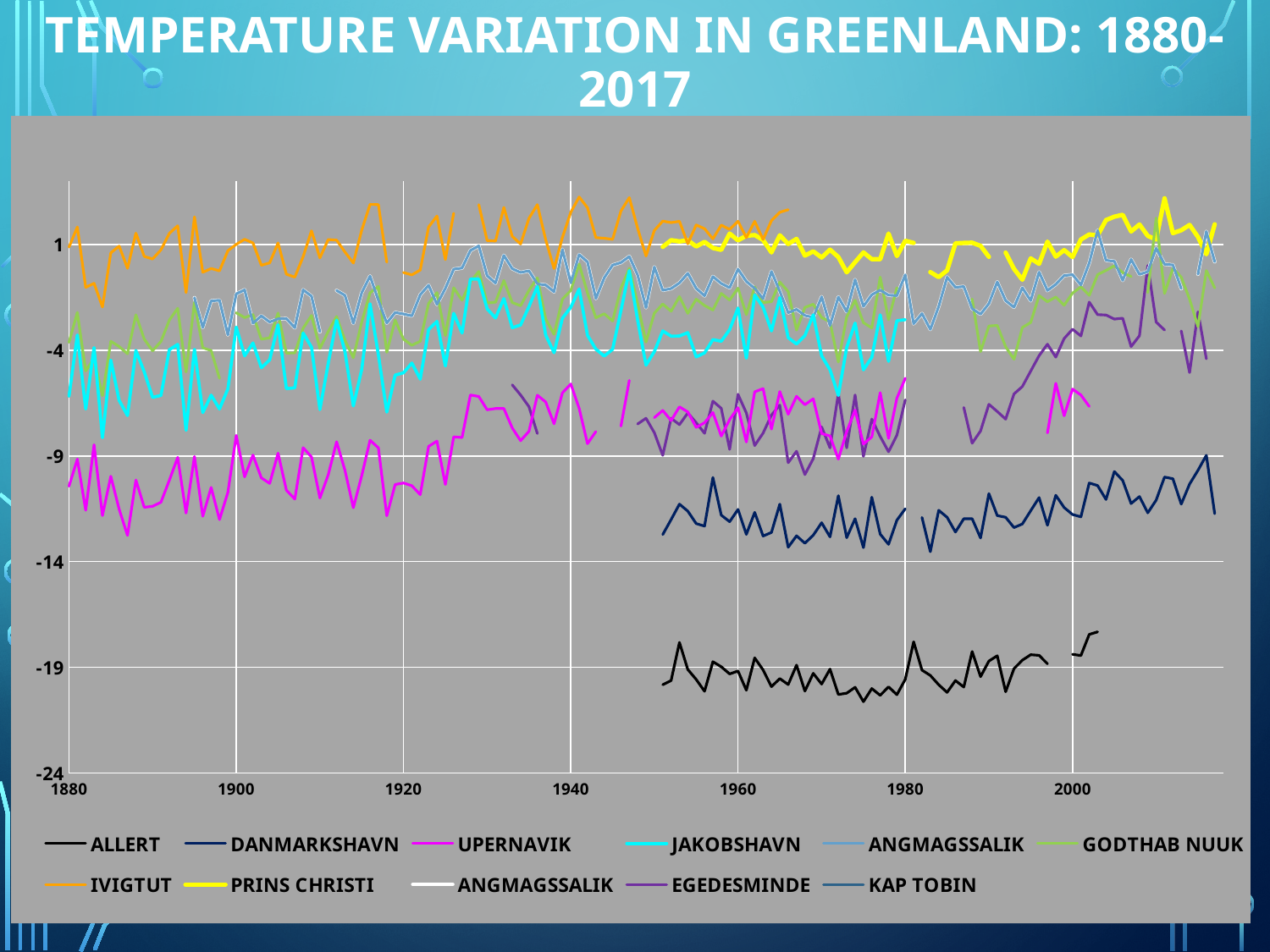
Are the values for DANMARKSHAVN greater or less than -9? less What kind of chart is shown on the slide? line chart Which series has higher values, UPERNAVIK or JAKOBSHAVN? JAKOBSHAVN Are the values for ALLERT greater or less than -14? less Is the value for UPERNAVIK around 1890 greater or less than -9? less Which series has the lowest values on the chart? ALLERT What is the title of the chart? TEMPERATURE VARIATION IN GREENLAND: 1880-2017 What is the lowest value labelled on the vertical axis? -24 Do the values for UPERNAVIK rise or fall between 1880 and 1940? rise Which series has higher values, ALLERT or DANMARKSHAVN? DANMARKSHAVN How many series does the legend list? 11